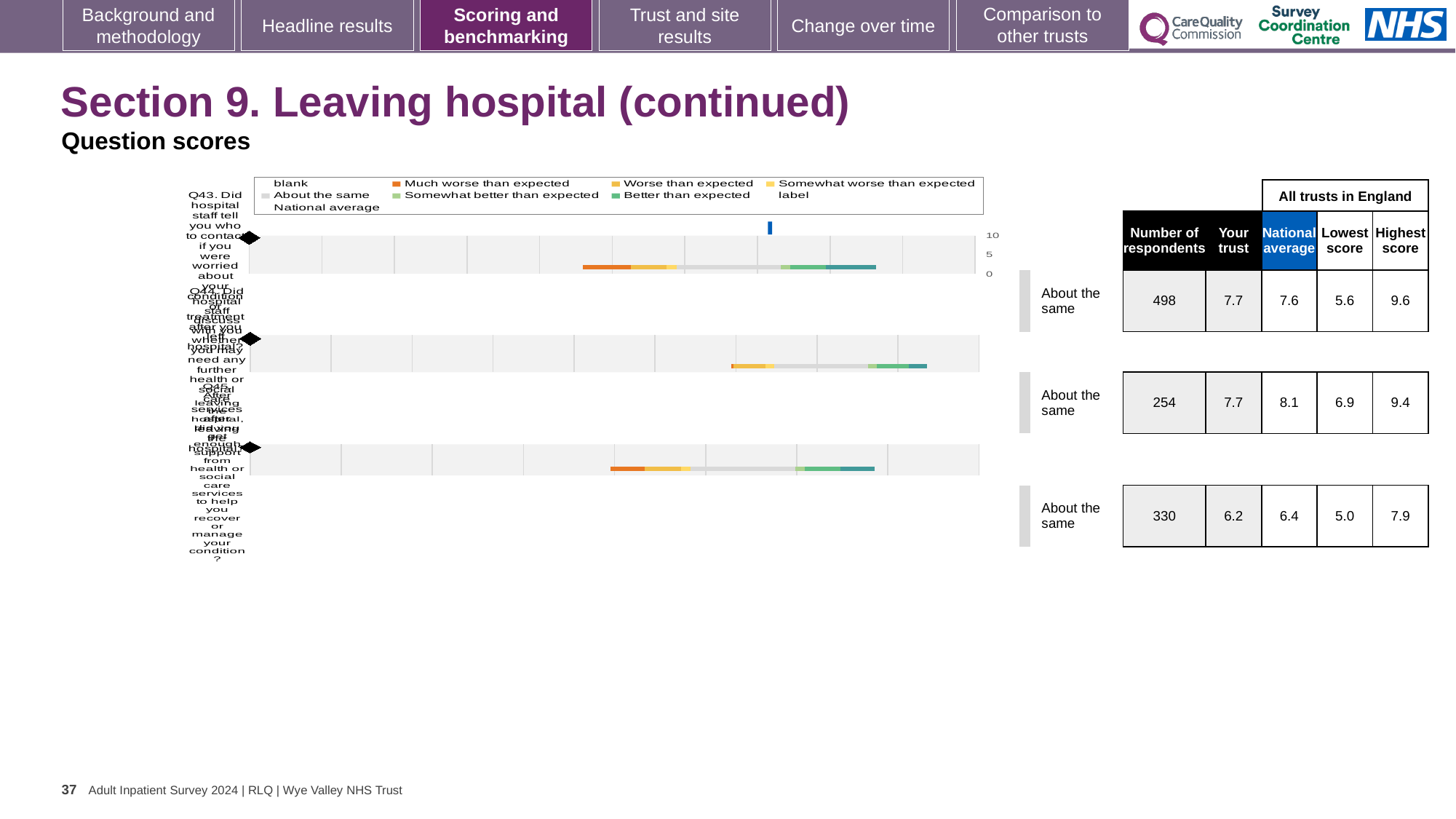
Which of the three questions has the highest number of respondents in the table beside the chart? Q43 Is the 'Your trust' score for Q45 greater or less than 5? greater What is the difference between the highest score and the lowest score for Q45 in the table beside the chart? 2.9 For Q44, which is larger: the 'Your trust' score or the national average? National average According to the table beside the chart, how many respondents answered Q45? 330 What is the maximum value shown on the chart's score axis? 10 Which of the three questions has the lowest 'Your trust' score in the table beside the chart? Q45 What benchmark category is shown for all three questions on this slide? About the same According to the table beside the chart, what is the 'Your trust' score for Q43? 7.7 How many questions (rows) are plotted in the chart? 3 According to the table beside the chart, what is the national average score for Q44? 8.1 What kind of chart is used to show the question scores on this slide? bar chart